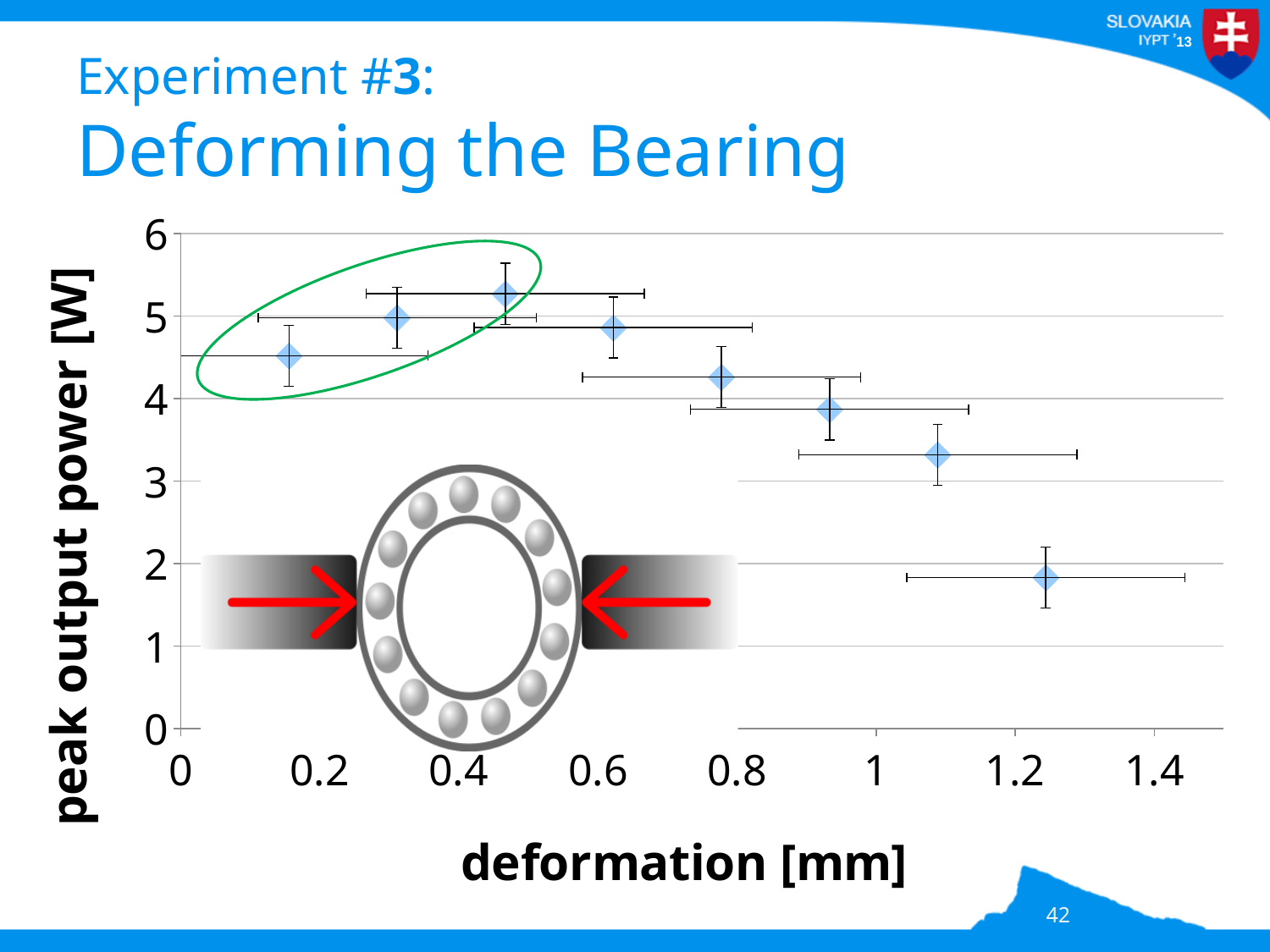
What is the label of the y axis? peak output power [W] How many data points are plotted in the chart? 8 Is the peak output power for the data point at a deformation of about 1.1 mm greater or less than 4 W? less Is the peak output power for the leftmost data point (deformation about 0.15 mm) greater or less than 4 W? greater For deformations above 0.5 mm, do the peak output power values rise or fall as deformation increases? fall Which has the higher peak output power: the point at about 0.78 mm deformation or the point at about 1.24 mm deformation? the point at about 0.78 mm Is the peak output power for the data point at a deformation of about 0.47 mm greater or less than 5 W? greater What kind of chart is shown on the slide? scatter plot Which data point has the lowest peak output power? the rightmost point What is the label of the x axis? deformation [mm]